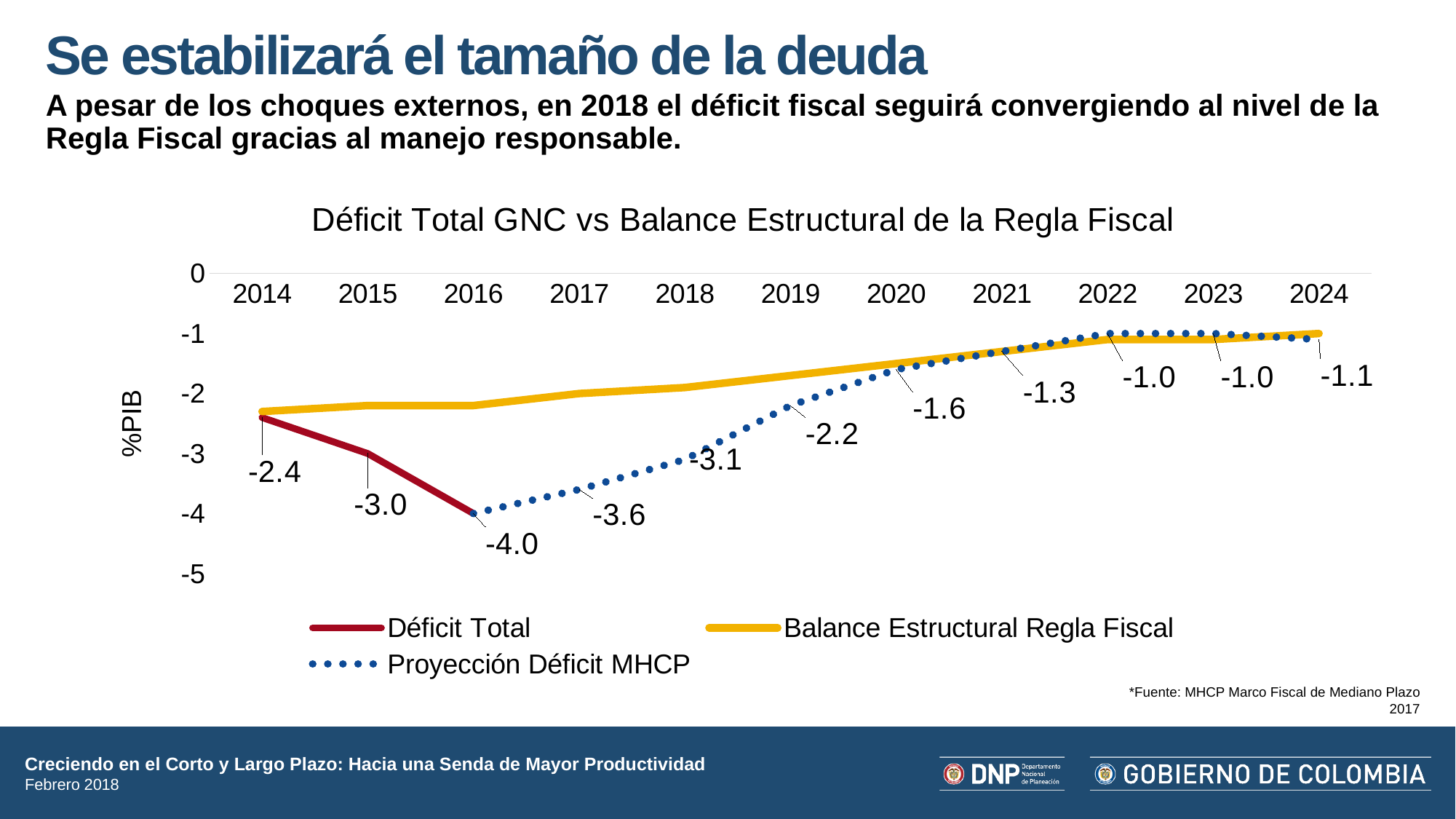
Does the Proyección Déficit MHCP series rise or fall from 2017 to 2022? rise What kind of chart is shown on the slide? line chart Is the Balance Estructural Regla Fiscal value for 2024 greater or less than -2? greater What is the Proyección Déficit MHCP value for 2019? -2.2 In which year is the labelled deficit value lowest (most negative)? 2016 Which is larger, the Proyección Déficit MHCP value for 2018 or for 2020? 2020 How many series does the legend list? 3 What is the value of Déficit Total in 2016? -4.0 What is the Proyección Déficit MHCP value for 2024? -1.1 How many years are shown on the x axis? 11 What is the difference between the Déficit Total in 2016 (-4.0) and the Proyección Déficit MHCP in 2017 (-3.6)? 0.4 What is the value of Déficit Total in 2014? -2.4